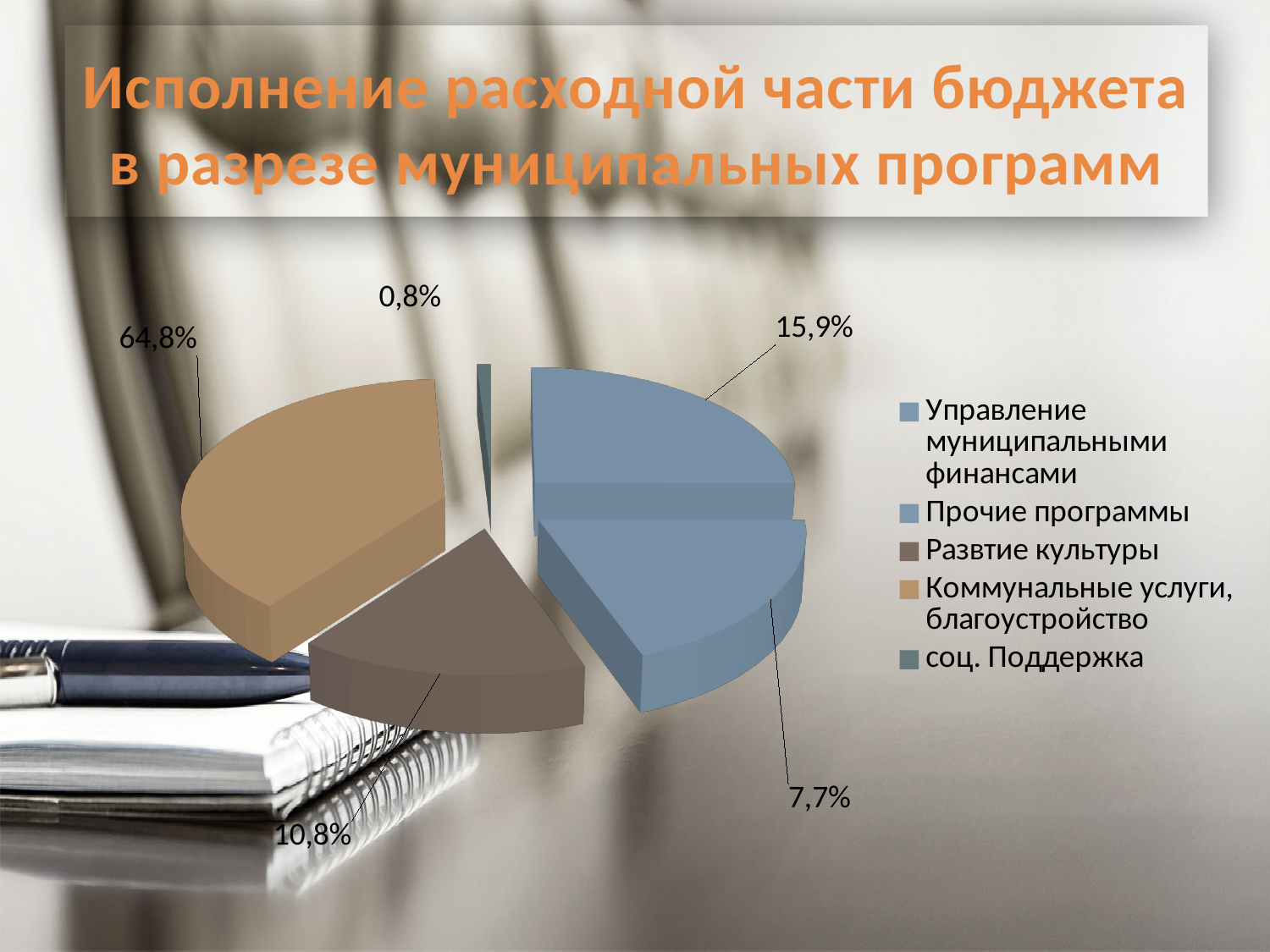
Which category has the largest slice of the pie? Коммунальные услуги, благоустройство What kind of chart is shown on the slide? pie chart What share of the pie does соц. Поддержка have? 0,8% How many categories does the legend list? 5 What share of the pie does Прочие программы have? 7,7% What is the difference between the shares of Управление муниципальными финансами and Прочие программы? 8,2% Which is larger, the share of Развтие культуры or the share of Прочие программы? Развтие культуры What share of the pie does Развтие культуры have? 10,8% Which category has the smallest slice of the pie? соц. Поддержка What is the title of the slide containing the chart? Исполнение расходной части бюджета в разрезе муниципальных программ What share of the pie does Коммунальные услуги, благоустройство have? 64,8% What share of the pie does Управление муниципальными финансами have? 15,9%